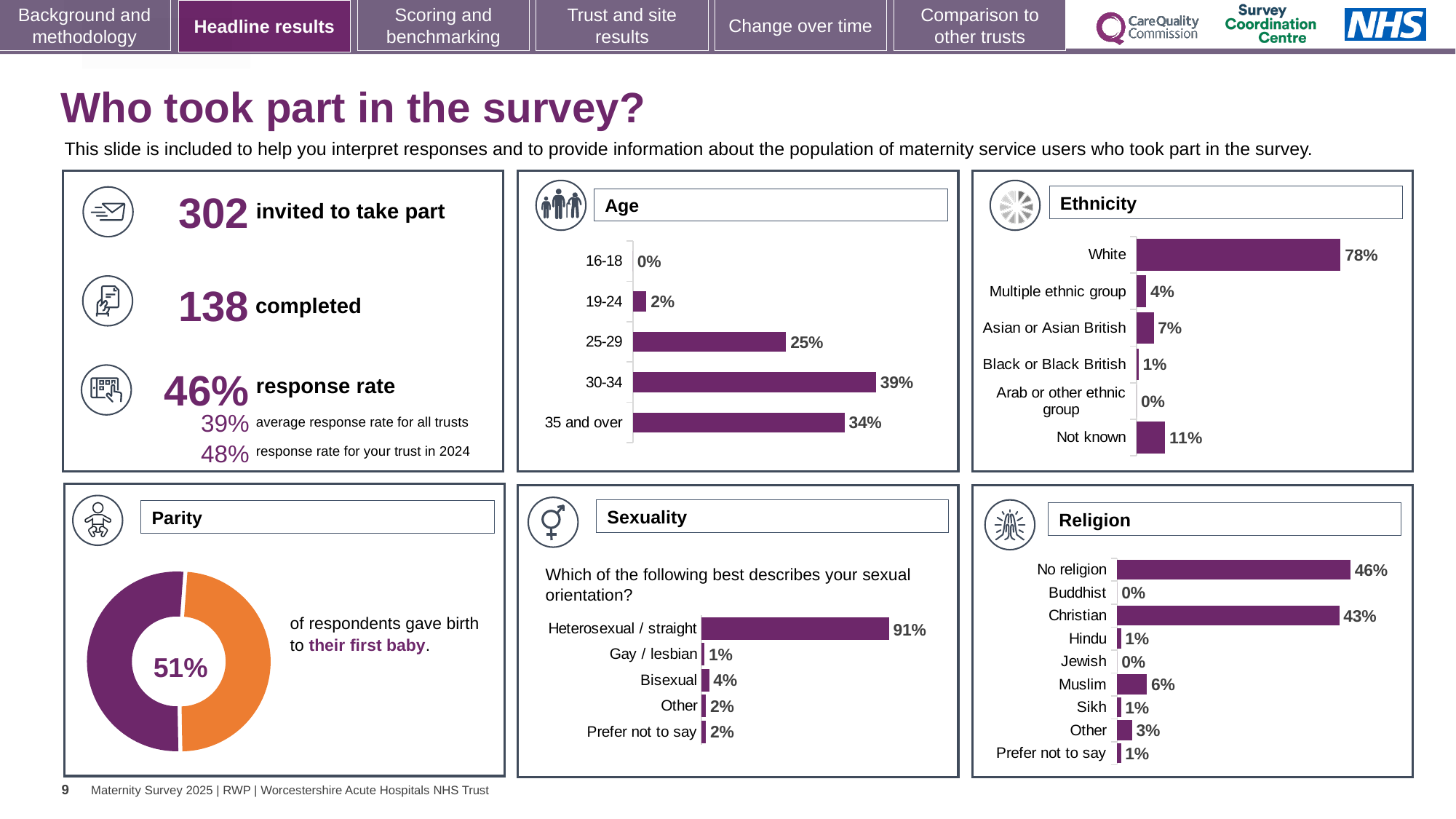
In the Age chart, what percentage of respondents were aged 30-34? 39% In the Religion chart, which is larger, No religion or Christian? No religion In the Parity chart, what share of respondents gave birth to their first baby? 51% In the Ethnicity chart, what is the value for Not known? 11% In the Ethnicity chart, what is the difference between White and Asian or Asian British? 71% How many categories does the Religion chart show? 9 In the Religion chart, what is the value for Muslim? 6% How many categories does the Age chart show? 5 In the Ethnicity chart, which category has the highest value? White What kind of chart is the Parity chart? Doughnut chart In the Age chart, what is the difference between the 30-34 and 25-29 values? 14% In the Sexuality chart, what percentage of respondents answered Heterosexual / straight? 91%